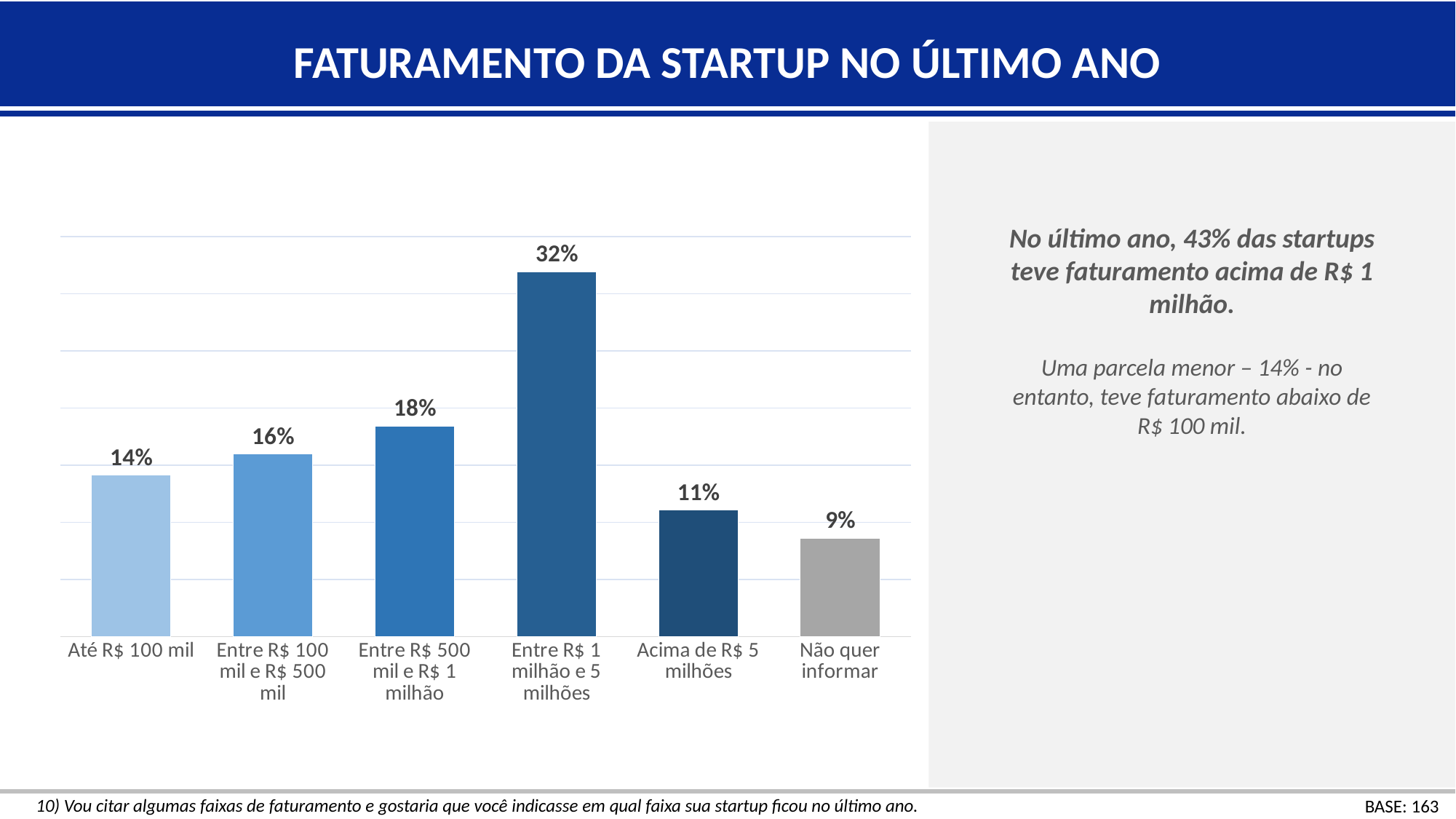
How many categories are shown in the chart? 6 What is the value for "Acima de R$ 5 milhões"? 11% Which category has the lowest value? Não quer informar What is the difference between the values for "Entre R$ 1 milhão e 5 milhões" and "Entre R$ 500 mil e R$ 1 milhão"? 14% What is the value for "Até R$ 100 mil"? 14% What is the value for "Entre R$ 1 milhão e 5 milhões"? 32% Which is larger, the value for "Entre R$ 100 mil e R$ 500 mil" or the value for "Acima de R$ 5 milhões"? Entre R$ 100 mil e R$ 500 mil What is the difference between the values for "Entre R$ 500 mil e R$ 1 milhão" and "Até R$ 100 mil"? 4% Which category has the highest value? Entre R$ 1 milhão e 5 milhões What is the value for "Não quer informar"? 9% What is the title of the slide? FATURAMENTO DA STARTUP NO ÚLTIMO ANO What kind of chart is shown on the slide? Bar chart